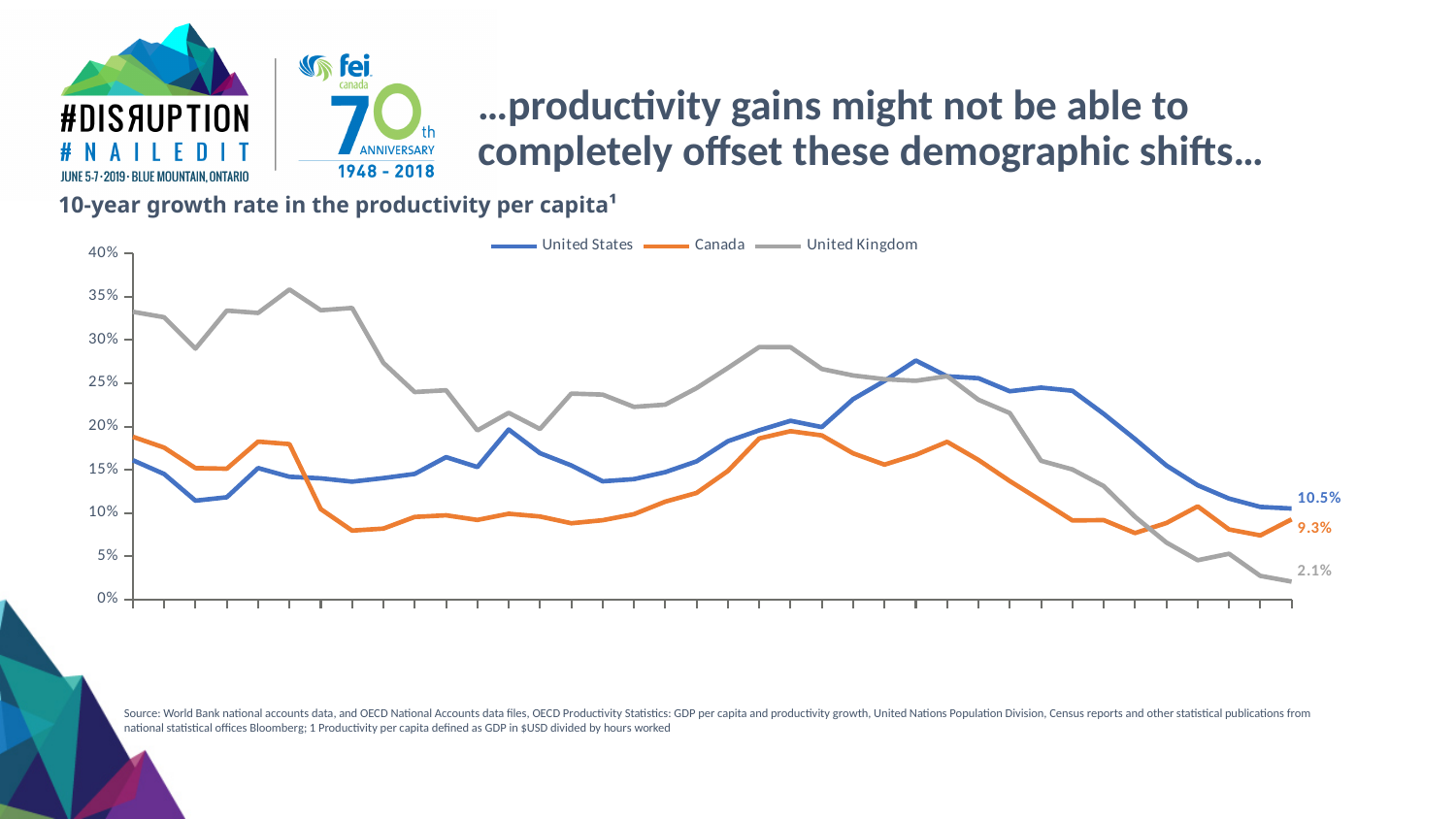
Which series has the lowest value at the right end of the chart? United Kingdom Is the United Kingdom value at the left end of the chart greater or less than 30%? greater What is the difference between the final labelled values for the United States and Canada? 1.2 percentage points What is the title of the chart? 10-year growth rate in the productivity per capita Does the United Kingdom line overall rise or fall from the left end to the right end of the chart? fall Which series has the highest value at the right end of the chart? United States What is the final labelled value for the Canada line? 9.3% What kind of chart is shown on the slide? line chart What is the final labelled value for the United Kingdom line? 2.1% At the right end of the chart, is the Canada value larger or smaller than the United Kingdom value? larger How many series does the legend list? 3 What is the final labelled value for the United States line? 10.5%